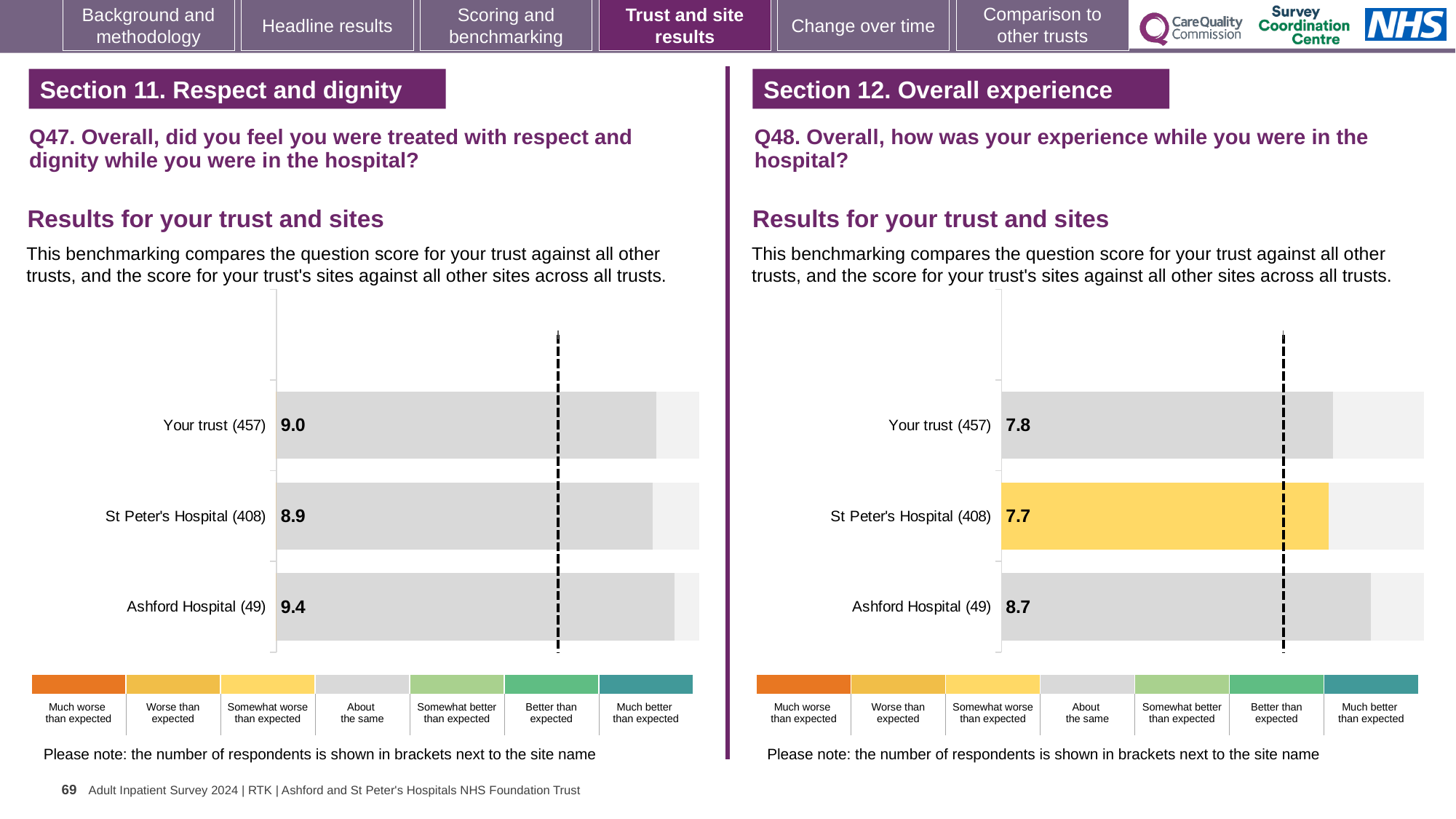
In the Q47 chart on the left, what is the score for Your trust (457)? 9.0 What kind of chart is used for the Q48 results on the right? Bar chart In the Q48 chart on the right, which has the larger score, Your trust (457) or Ashford Hospital (49)? Ashford Hospital (49) In the Q47 chart on the left, what is the score for Ashford Hospital (49)? 9.4 In the Q47 chart on the left, which site or trust has the highest score? Ashford Hospital (49) In the Q47 chart on the left, what is the difference between the scores for Ashford Hospital (49) and St Peter's Hospital (408)? 0.5 In the Q48 chart on the right, what is the difference between the scores for Ashford Hospital (49) and Your trust (457)? 0.9 In the Q48 chart on the right, what is the score for St Peter's Hospital (408)? 7.7 In the Q48 chart on the right, which site or trust has the lowest score? St Peter's Hospital (408) In the Q48 chart on the right, what is the score for Ashford Hospital (49)? 8.7 In the Q48 chart on the right, which benchmark category does the yellow bar for St Peter's Hospital (408) represent according to the legend? Somewhat worse than expected How many sites or trusts are plotted in the Q47 chart on the left? 3